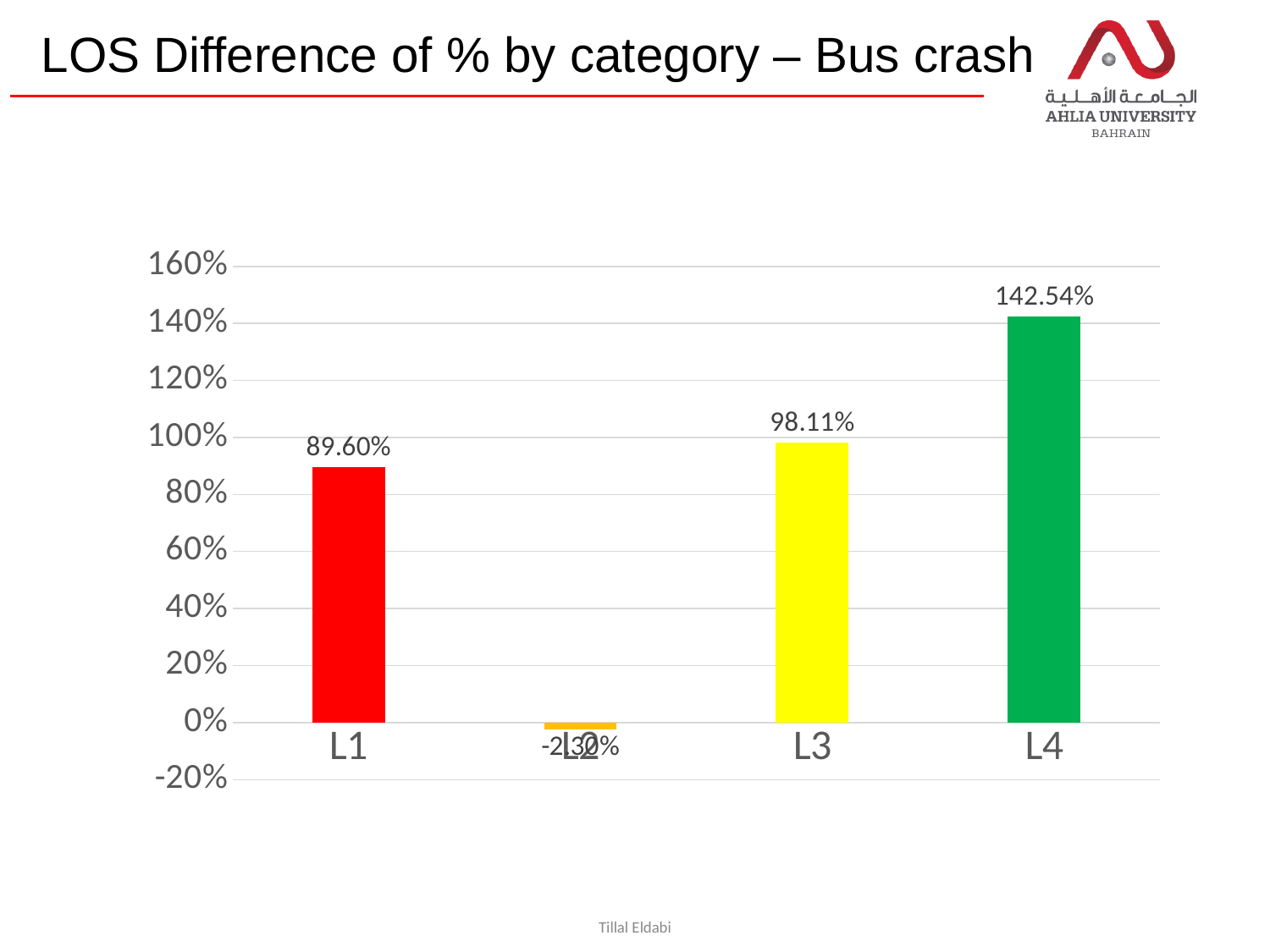
What colour is the bar for L4? green What is the value for L1? 89.60% Which category has the lowest value? L2 What is the value for L3? 98.11% What is the difference between the values for L4 and L1? 52.94% How many categories are shown on the x axis? 4 Which category has the highest value? L4 What is the difference between the values for L3 and L1? 8.51% Which is larger, the value for L1 or the value for L3? L3 What is the value for L4? 142.54% Is the value for L2 greater or less than 0%? less What kind of chart is shown on the slide? bar chart